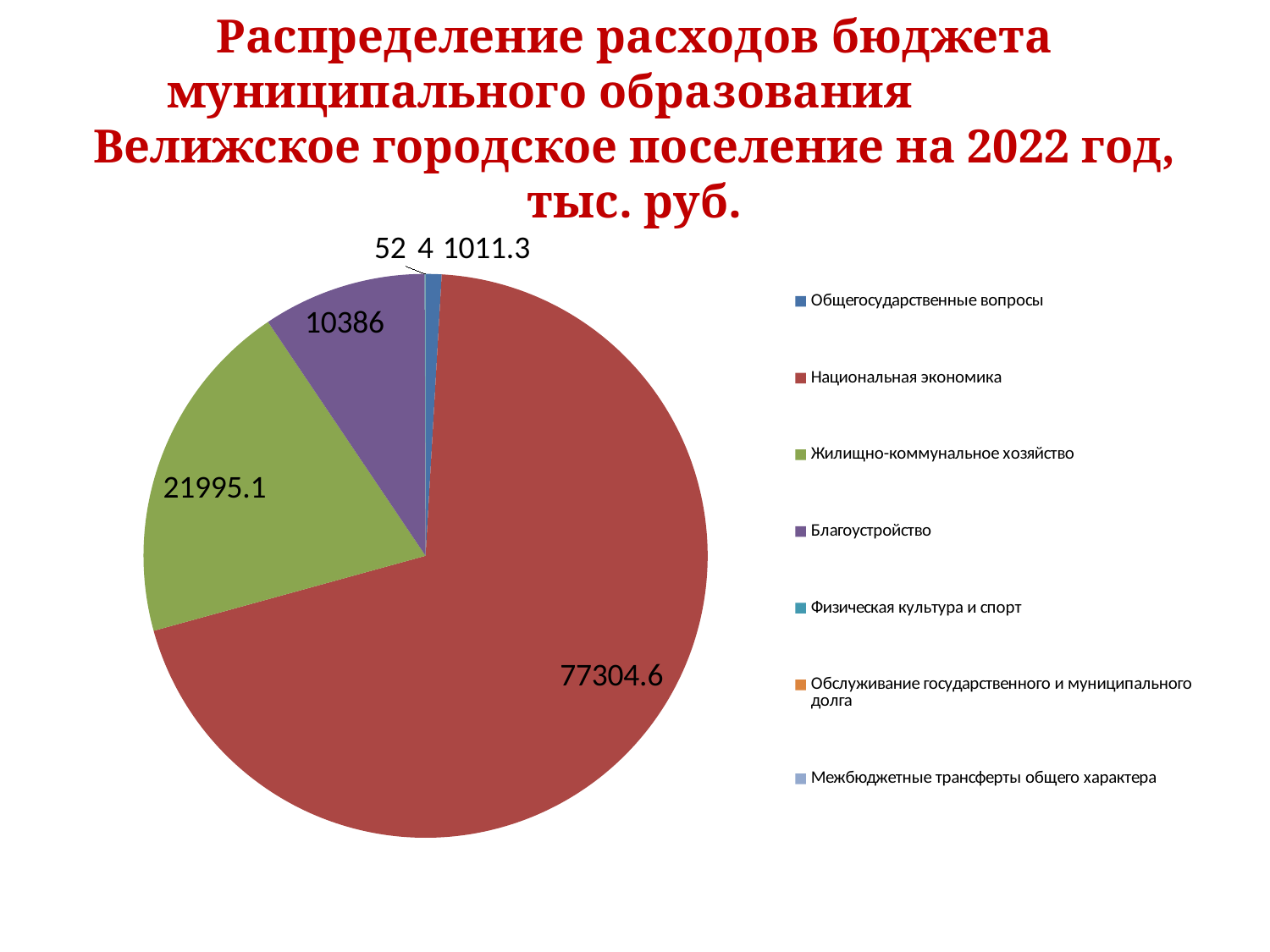
Which category has the largest slice in the pie chart? Национальная экономика What colour is the slice for Национальная экономика? red For which year does the chart title say the budget expenditures are distributed? 2022 What is the difference between the values for Национальная экономика and Жилищно-коммунальное хозяйство? 55309.5 What is the value for Национальная экономика in the pie chart? 77304.6 Which is larger: Жилищно-коммунальное хозяйство or Благоустройство? Жилищно-коммунальное хозяйство How many categories does the legend of the pie chart list? 7 What is the value for Жилищно-коммунальное хозяйство in the pie chart? 21995.1 What is the value for Общегосударственные вопросы in the pie chart? 1011.3 What is the value for Благоустройство in the pie chart? 10386 What type of chart is shown on the slide? pie chart What is the difference between the values for Жилищно-коммунальное хозяйство and Благоустройство? 11609.1